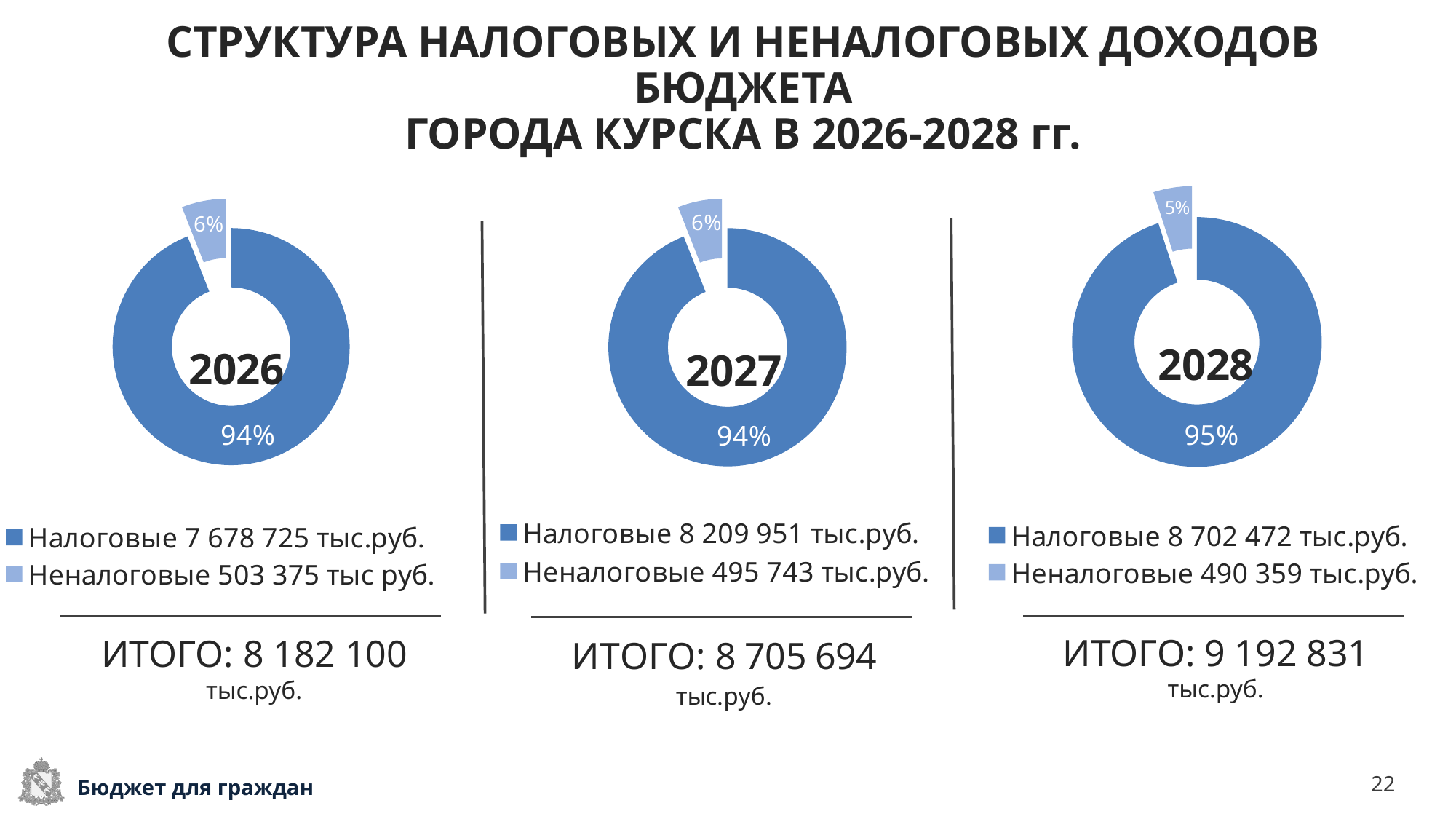
In the 2027 chart, what is the value of tax revenues (Налоговые) shown in the legend? 8 209 951 тыс.руб. What is the difference between tax revenues (Налоговые) and non-tax revenues (Неналоговые) in the 2028 chart? 8 212 113 тыс.руб. In the 2028 chart, what is the value of tax revenues (Налоговые) shown in the legend? 8 702 472 тыс.руб. In the 2026 chart, what is the value of non-tax revenues (Неналоговые) shown in the legend? 503 375 тыс руб. What is the total (ИТОГО) shown under the 2027 chart? 8 705 694 тыс.руб. In the 2027 chart, which category is larger, Налоговые or Неналоговые? Налоговые How many categories does each chart's legend list? 2 How many doughnut charts are shown on the slide? 3 What type of chart is used for each year on this slide? Doughnut (pie) chart In the 2026 chart, what share of the total do tax revenues (Налоговые) make up? 94% What is the total (ИТОГО) shown under the 2028 chart? 9 192 831 тыс.руб. In the 2028 chart, what share of the total do non-tax revenues (Неналоговые) make up? 5%